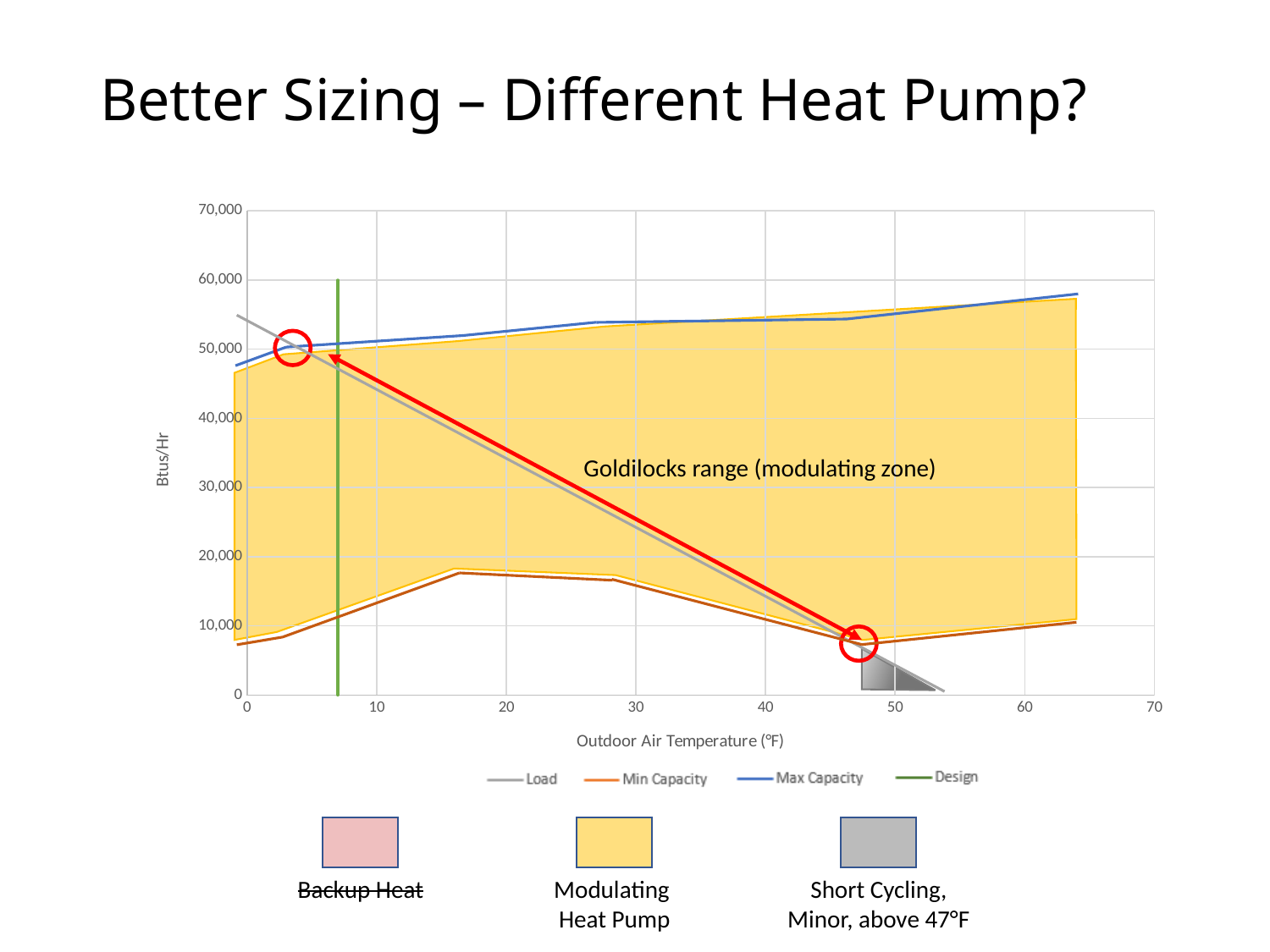
Is the Load value at 40°F greater or less than 20,000? less Is the Load value at 0°F greater or less than 50,000? greater What kind of chart is shown on the slide? line chart Does the Max Capacity series generally rise or fall as outdoor air temperature increases? rise At 20°F, which is larger: the Load value or the Min Capacity value? Load What is the title of the chart's vertical axis? Btus/Hr Is the Min Capacity value at 30°F greater or less than 20,000? less How many series does the chart legend list? 4 Does the Load series rise or fall as outdoor air temperature increases? fall What are the series names listed in the chart legend? Load, Min Capacity, Max Capacity, Design